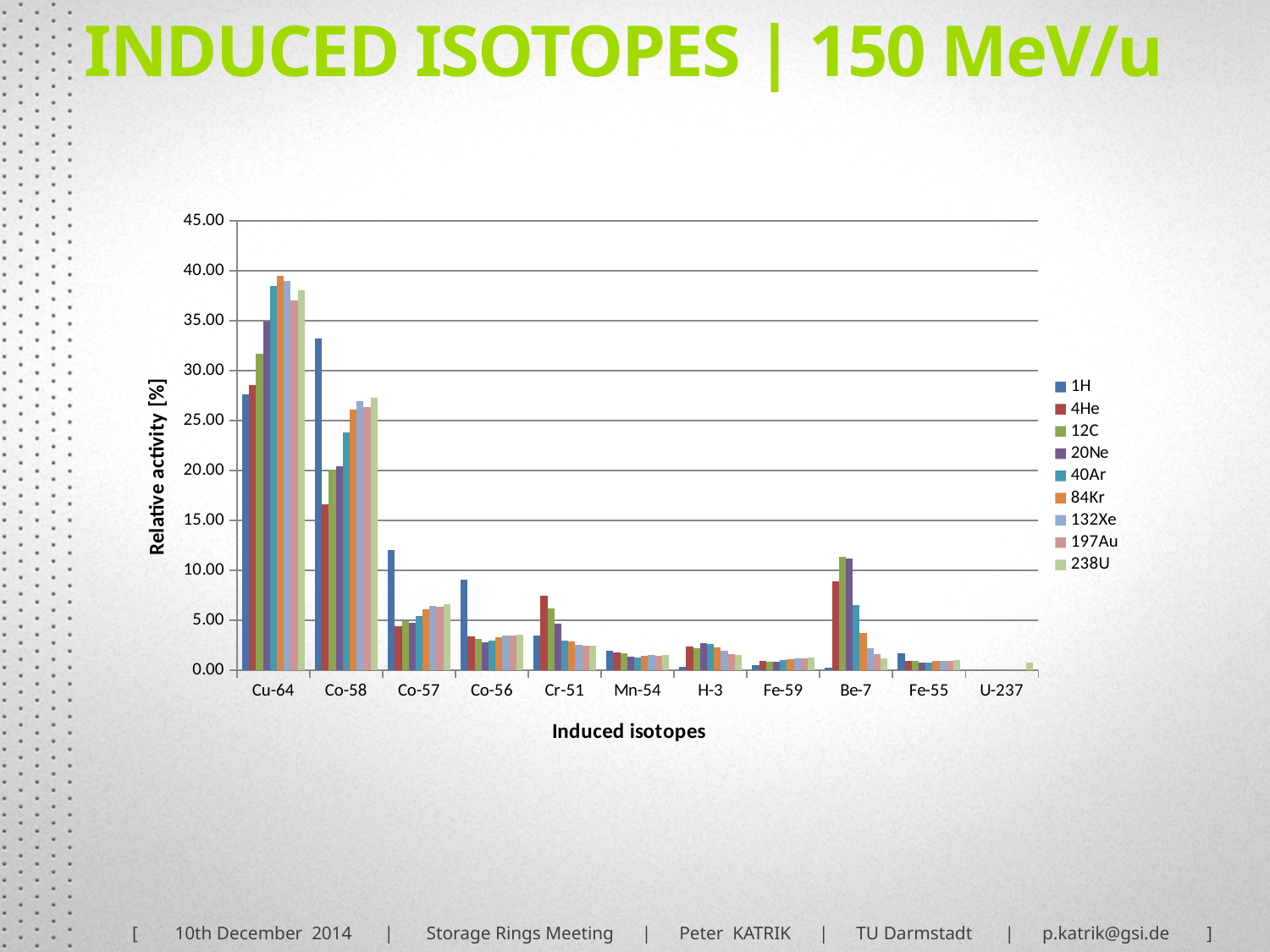
How many induced isotopes (categories) are shown on the x axis? 11 Is the value of the 84Kr series for Cu-64 greater or less than 35.00? greater What is the label of the y axis? Relative activity [%] Is the value of the 1H series for Co-58 greater or less than 30.00? greater Is the value of the 1H series for Co-57 greater or less than 10.00? greater What is the label of the x axis? Induced isotopes How many series does the legend list? 9 For the 1H series, which is larger: the value for Cu-64 or the value for Co-58? Co-58 Which series has the lowest value for Co-58? 4He Which series has the highest value for Co-58? 1H What kind of chart is shown on the slide? bar chart